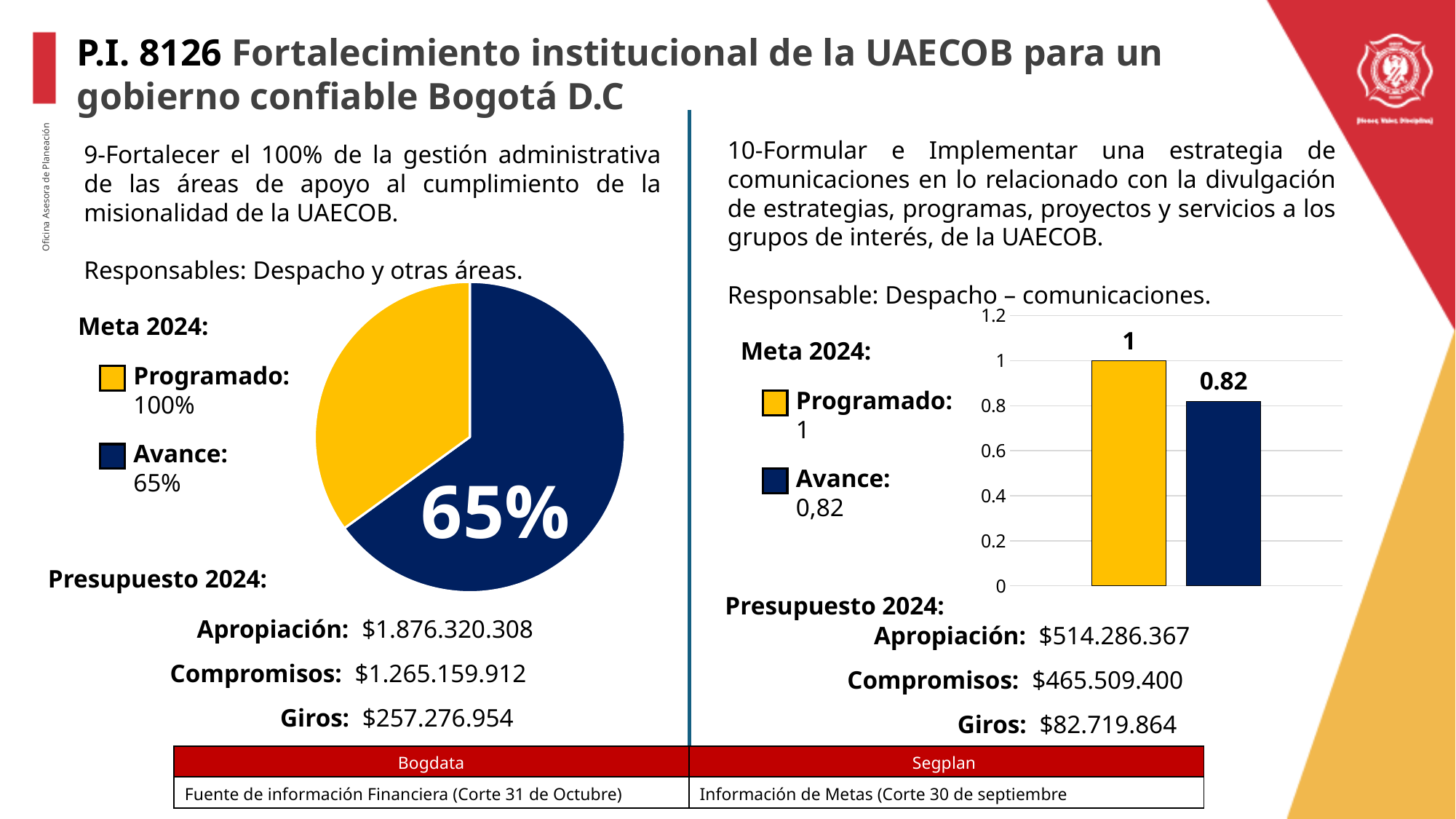
On the pie chart on the left, which colour represents 'Avance'? dark blue On the bar chart on the right, which bar is taller, 'Programado' or 'Avance'? Programado What kind of chart is shown on the right side of the slide, under 'Meta 2024' for goal 10? bar chart On the pie chart on the left, what value is printed on the dark blue slice? 65% On the bar chart on the right, what is the value of the 'Avance' bar? 0.82 On the bar chart on the right, what is the highest value shown on the vertical axis? 1.2 On the pie chart on the left, how many entries does the legend list? 2 On the bar chart on the right, what is the difference between the 'Programado' and 'Avance' values? 0.18 On the bar chart on the right, how many bars are plotted? 2 On the bar chart on the right, what is the value of the 'Programado' bar? 1 What kind of chart is shown on the left side of the slide, under 'Meta 2024' for goal 9? pie chart On the bar chart on the right, is the value for 'Avance' greater or less than 1? less